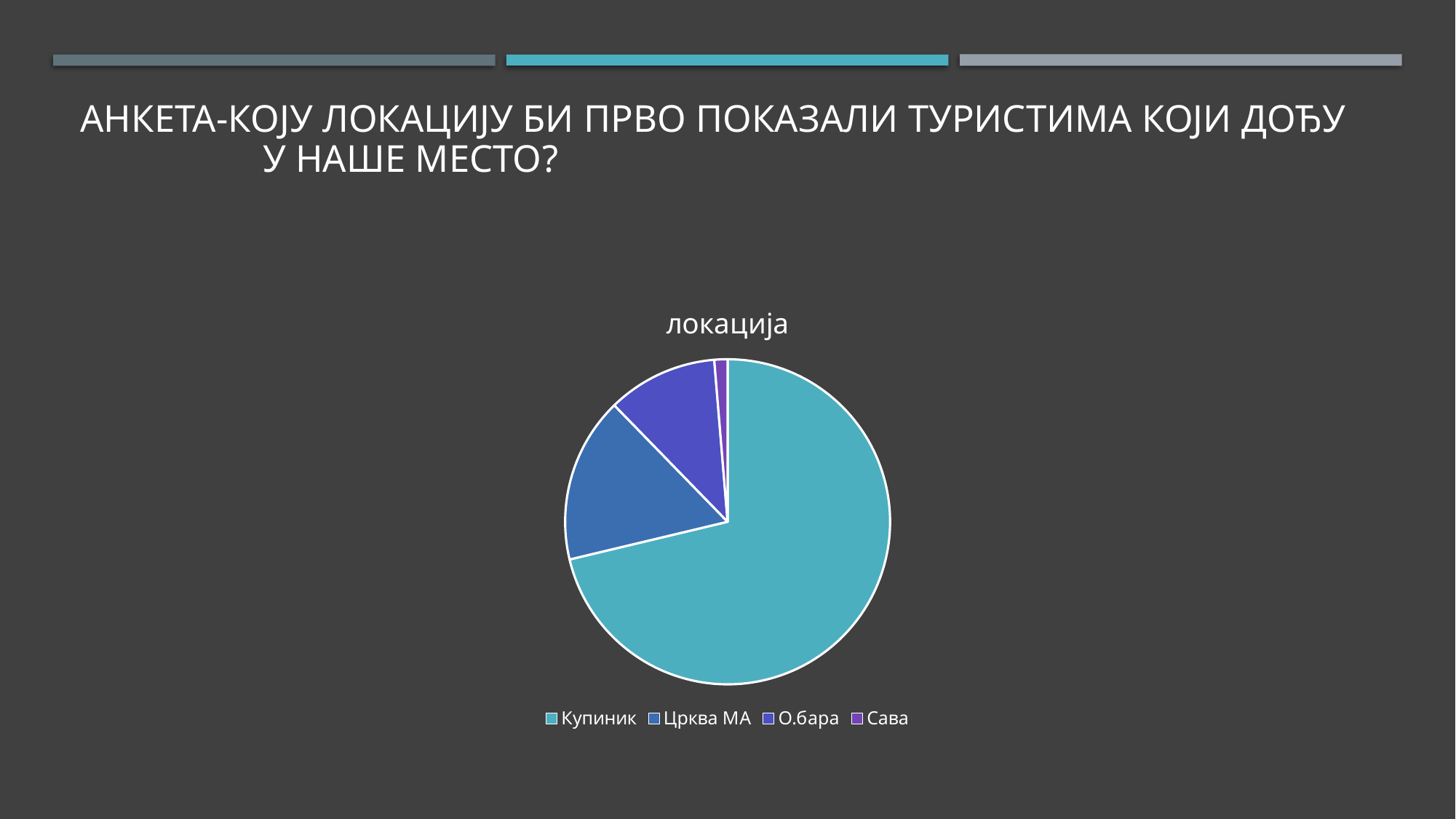
What is the title of the chart? локација Which legend entry is listed first? Купиник How many entries does the legend list? 4 Which slice is larger, Црква МА or О.бара? Црква МА Which category has the largest slice of the pie? Купиник What kind of chart is shown on the slide? pie chart Which category has the smallest slice of the pie? Сава Which slice is larger, О.бара or Сава? О.бара How many slices does the pie chart have? 4 Does the Купиник slice take up more or less than half of the pie? more Which slice is larger, Купиник or Црква МА? Купиник